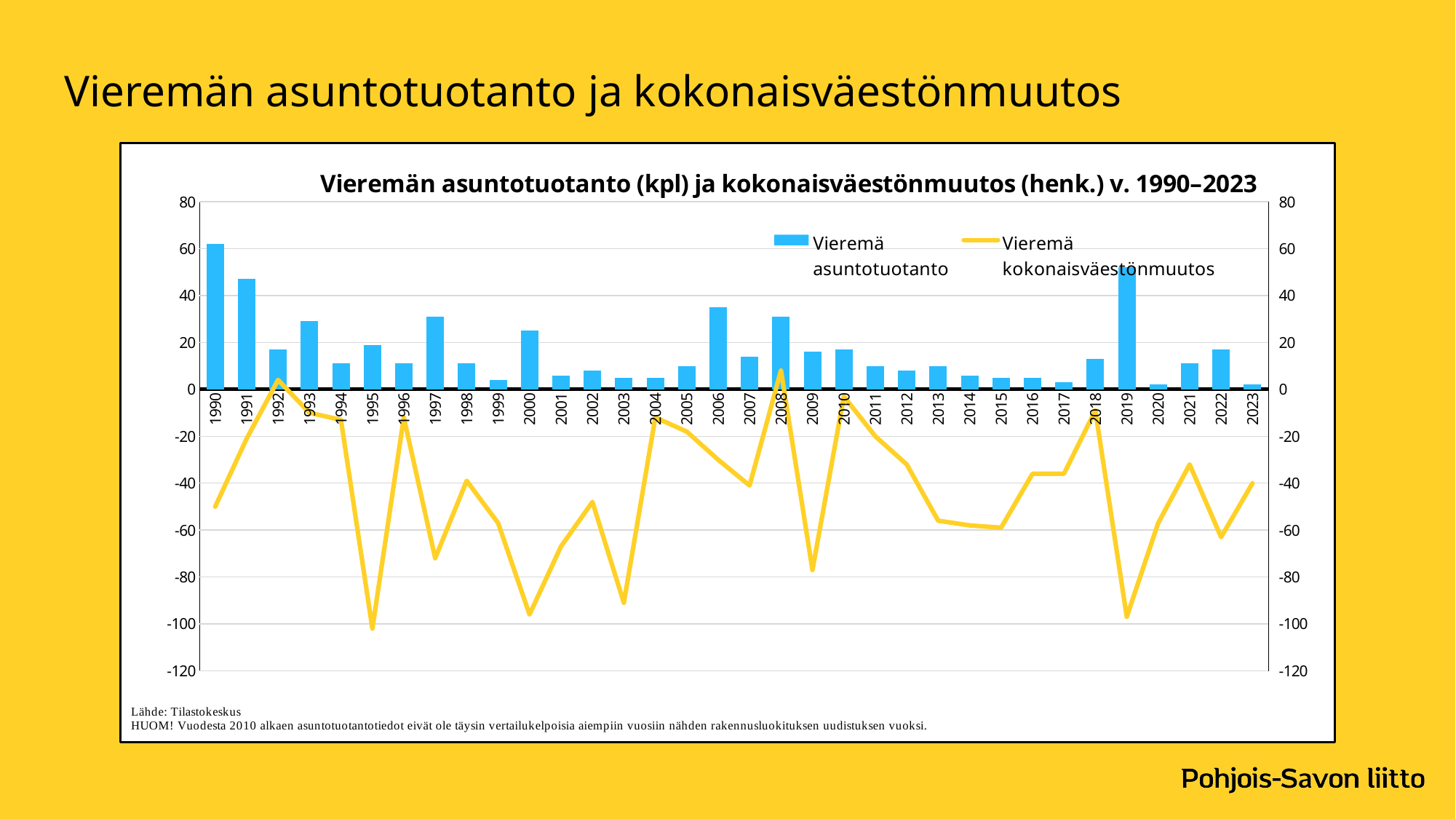
Which year has the highest bar for Vieremä asuntotuotanto? 1990 Is the Vieremä asuntotuotanto bar for 1990 greater or less than 40? greater Which year has the larger Vieremä asuntotuotanto bar, 2000 or 2005? 2000 Is the Vieremä kokonaisväestönmuutos value for 1995 greater or less than -80? less Which year has the larger Vieremä asuntotuotanto bar, 1991 or 1997? 1991 How many series does the legend list? 2 How many years are shown on the x axis? 34 Is the Vieremä kokonaisväestönmuutos value for 2013 greater or less than -40? less What kind of chart is shown on the slide? A combined bar and line chart Does the Vieremä kokonaisväestönmuutos line rise or fall from 2019 to 2021? rise In which year does the Vieremä kokonaisväestönmuutos line reach its highest point? 2008